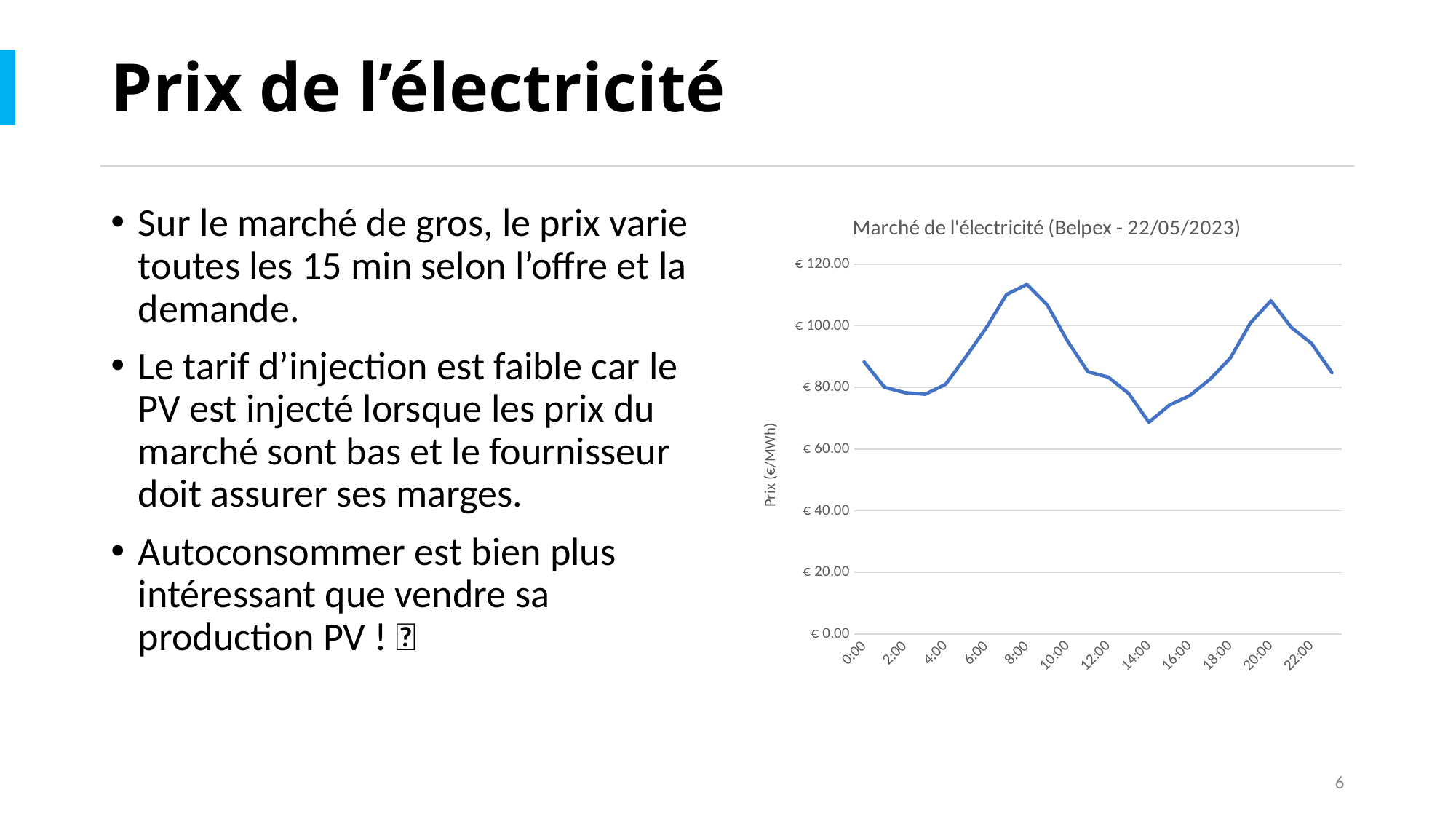
What is the title of the chart? Marché de l'électricité (Belpex - 22/05/2023) What is the label of the vertical axis of the chart? Prix (€/MWh) Is the price at 2:00 greater or less than € 100.00? less At which time of day does the electricity price reach its highest value? 8:00 Is the price at 14:00 greater or less than € 80.00? less Which is higher, the price at 8:00 or the price at 14:00? 8:00 How many time labels are shown on the horizontal axis? 12 At which time of day does the electricity price reach its lowest value? 14:00 Does the price rise or fall between 8:00 and 14:00? fall Is the price at 8:00 greater or less than € 100.00? greater What kind of chart is shown on the slide? line chart